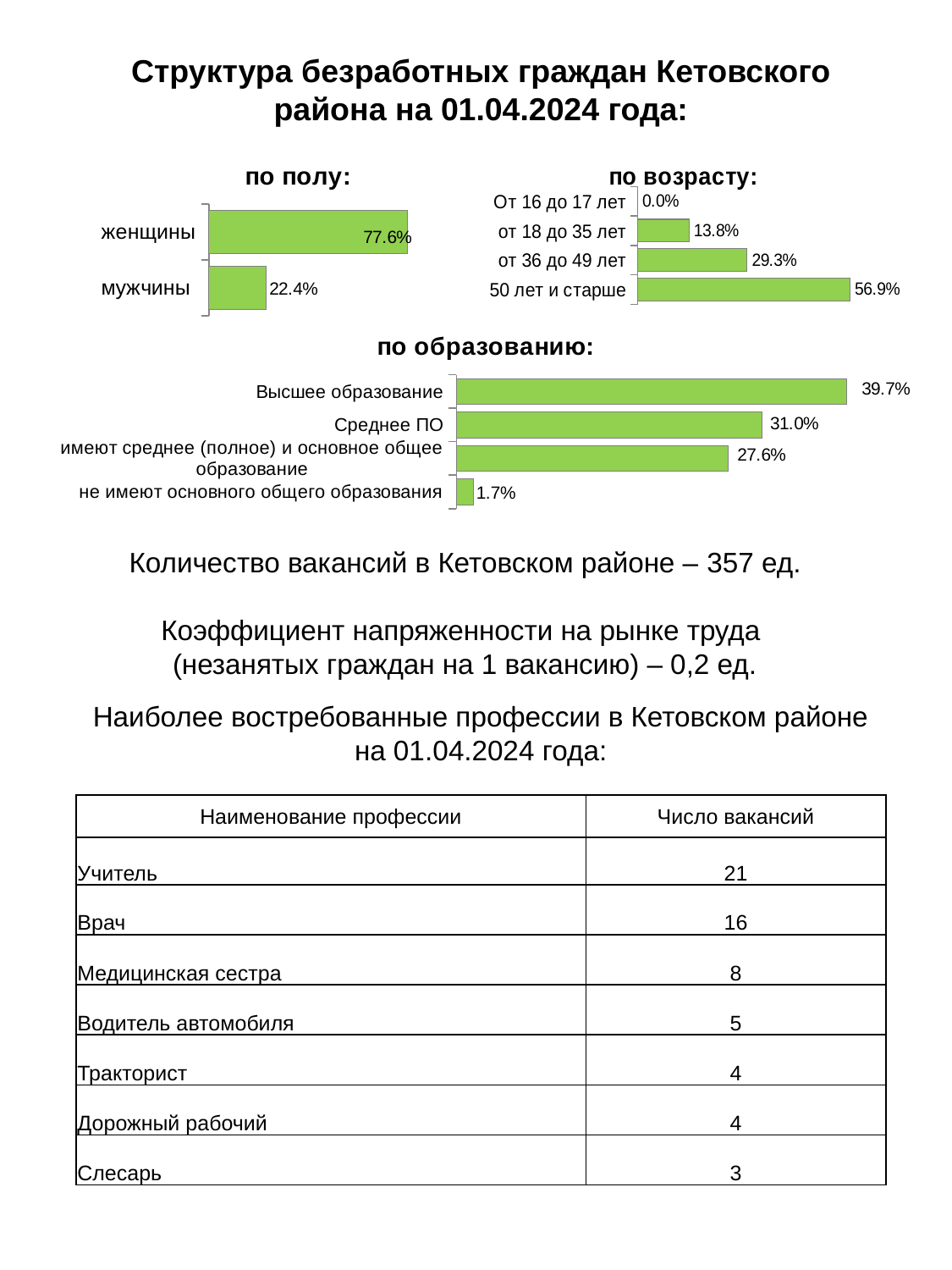
In the 'по образованию' chart, what is the difference between 'Высшее образование' and 'не имеют основного общего образования'? 38.0% What type of chart is the 'по полу' chart? Bar chart In the 'по возрасту' chart, how many age categories are shown? 4 In the 'по полу' chart, what is the value for женщины? 77.6% In the 'по возрасту' chart, which age group has the lowest value? От 16 до 17 лет In the 'по полу' chart, what is the value for мужчины? 22.4% In the 'по образованию' chart, which category has the highest value? Высшее образование In the 'по образованию' chart, which is larger: 'Среднее ПО' or 'имеют среднее (полное) и основное общее образование'? Среднее ПО In the 'по образованию' chart, what is the value for 'Среднее ПО'? 31.0% In the 'по полу' chart, what is the difference between the values for женщины and мужчины? 55.2% In the 'по возрасту' chart, which age group has the highest value? 50 лет и старше In the 'по возрасту' chart, what is the value for 'от 36 до 49 лет'? 29.3%